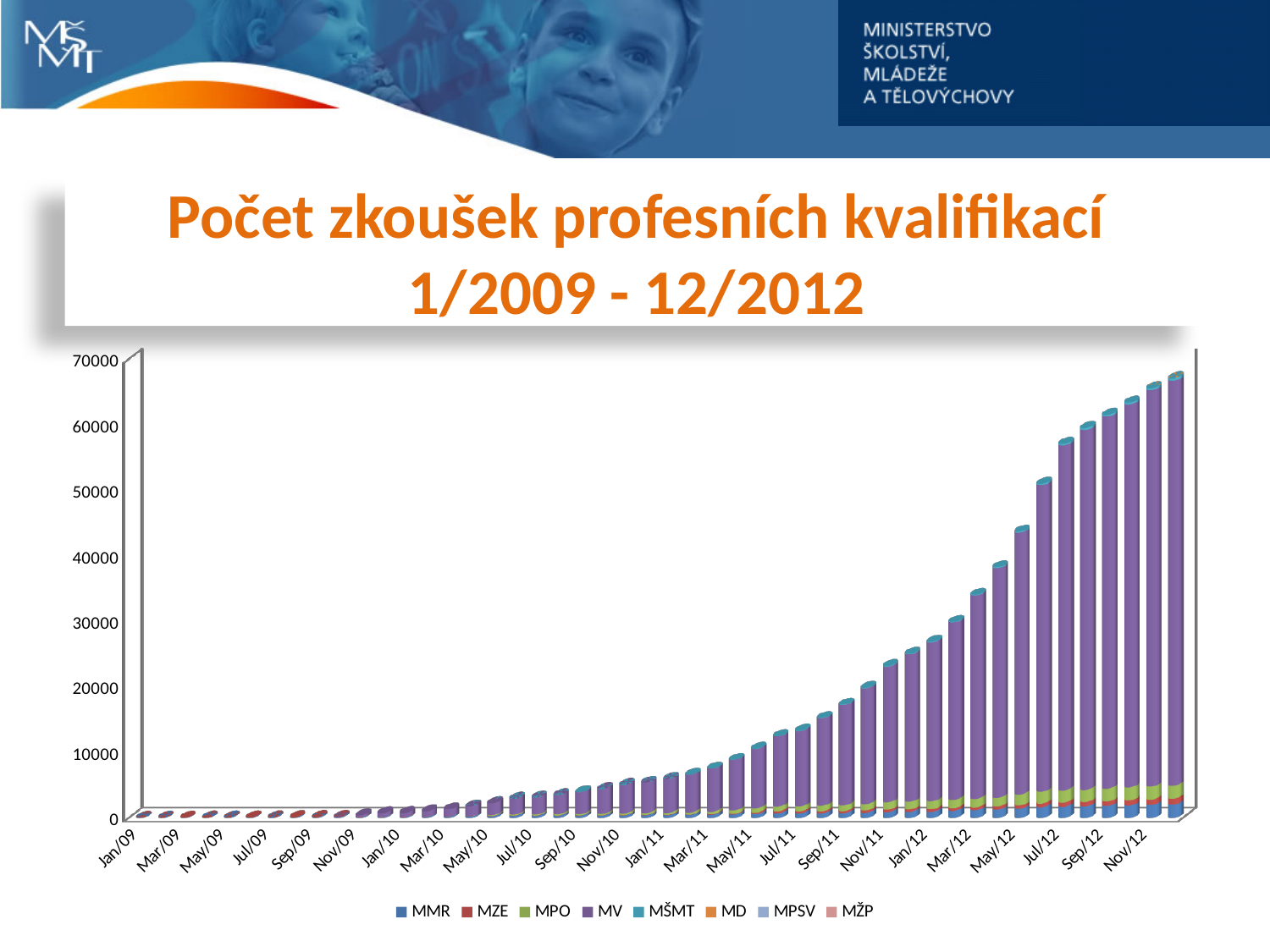
What is the highest value shown on the vertical axis? 70000 Which series makes up the largest part of the stacked bars? MV Which has the larger total, Jan/09 or Nov/12? Nov/12 What is the title of the chart? Počet zkoušek profesních kvalifikací 1/2009 - 12/2012 Is the total for Jan/12 greater or less than 20000? greater Is the total for Nov/12 greater or less than 60000? greater Is the total for Mar/12 greater or less than 40000? less Do the bar totals rise or fall from Jan/09 to Nov/12? Rise Which has the larger total, Sep/11 or Sep/12? Sep/12 What kind of chart is shown on the slide? Stacked bar chart How many series does the legend list? 8